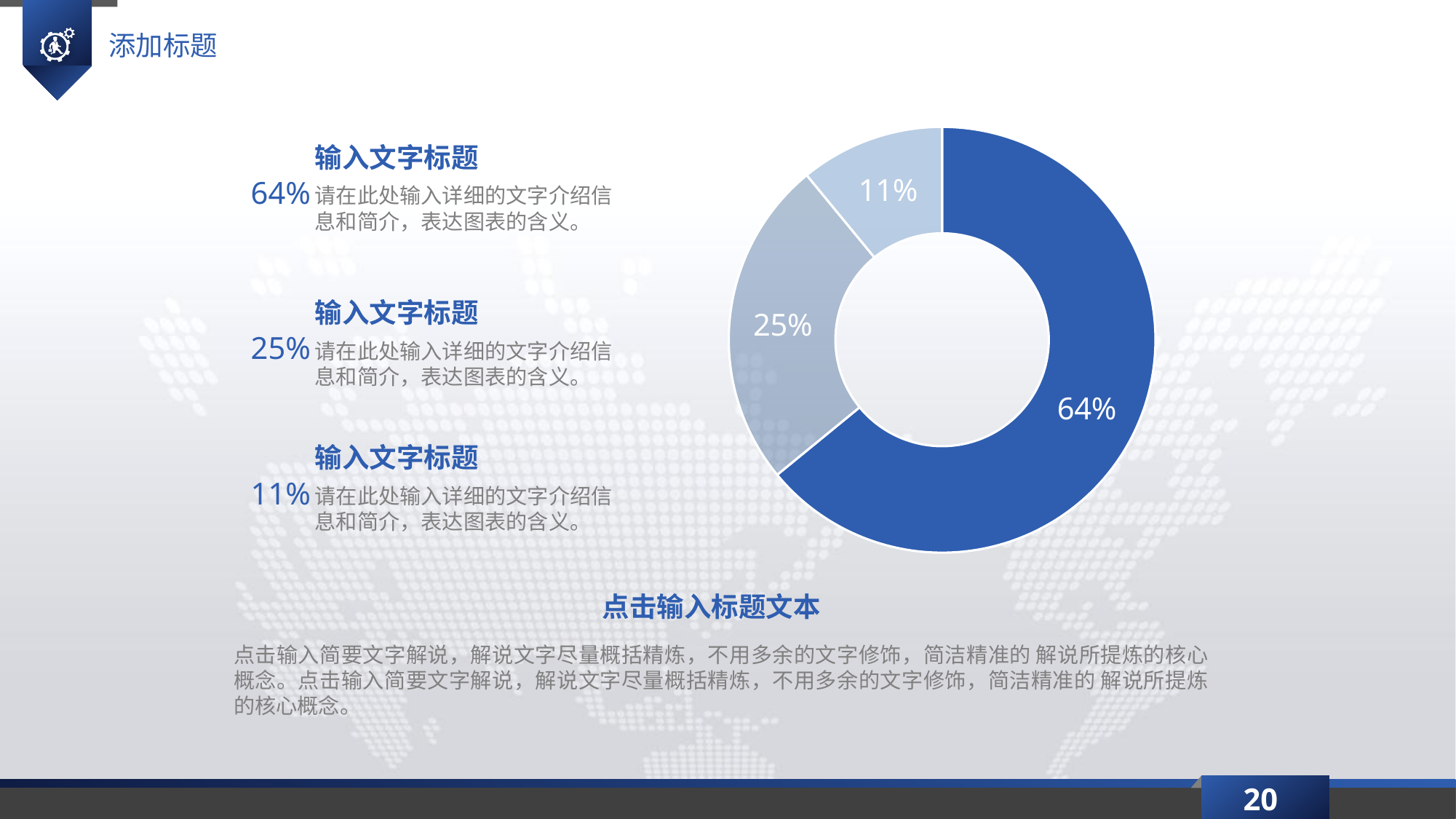
What is the value of the smallest slice in the doughnut chart? 11% What value is shown on the medium grey-blue slice on the left of the doughnut chart? 25% What do the three slice values of the doughnut chart add up to? 100% What share of the doughnut does the dark blue slice represent? 64% How many slices does the doughnut chart have? 3 Which slice is larger, the dark blue one or the lightest blue one? the dark blue one What value is shown on the dark blue slice of the doughnut chart? 64% What is the difference between the largest slice (64%) and the smallest slice (11%)? 53% What kind of chart is shown on the slide? doughnut chart What value is shown on the lightest blue slice of the doughnut chart? 11% What is the value of the largest slice in the doughnut chart? 64% What is the difference between the 25% slice and the 11% slice? 14%